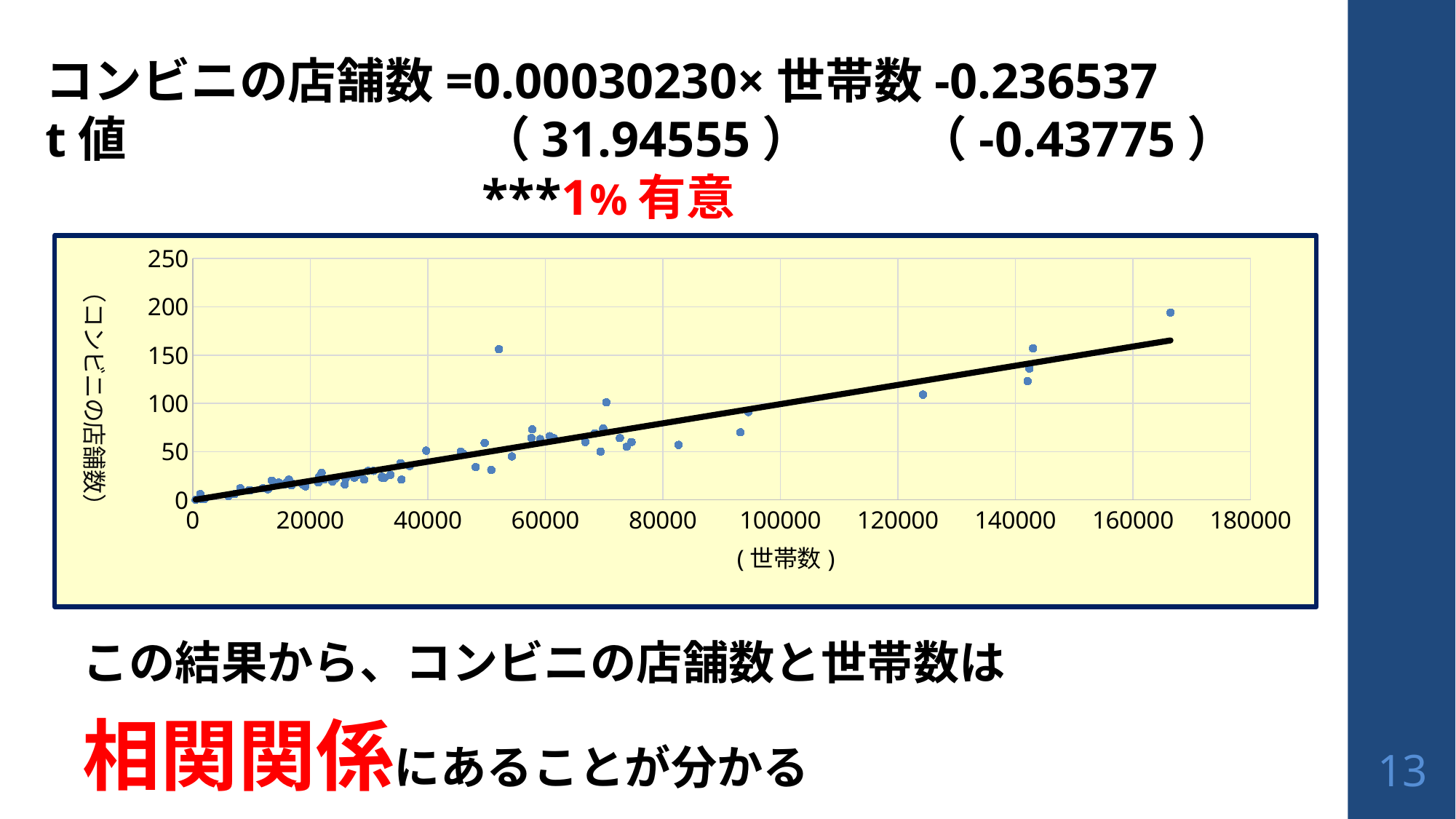
What is the label of the y axis of the chart? (コンビニの店舗数) Is the value for the point at roughly 83000 households greater or less than 100? less Is the value for the highest point at roughly 143000 households greater or less than 100? greater Do the plotted values generally rise or fall as the number of households (世帯数) increases along the x axis? rise Is the value for the outlying point at roughly 52000 households greater or less than 100? greater What kind of chart is shown on the slide? scatter chart What is the label of the x axis of the chart? (世帯数)